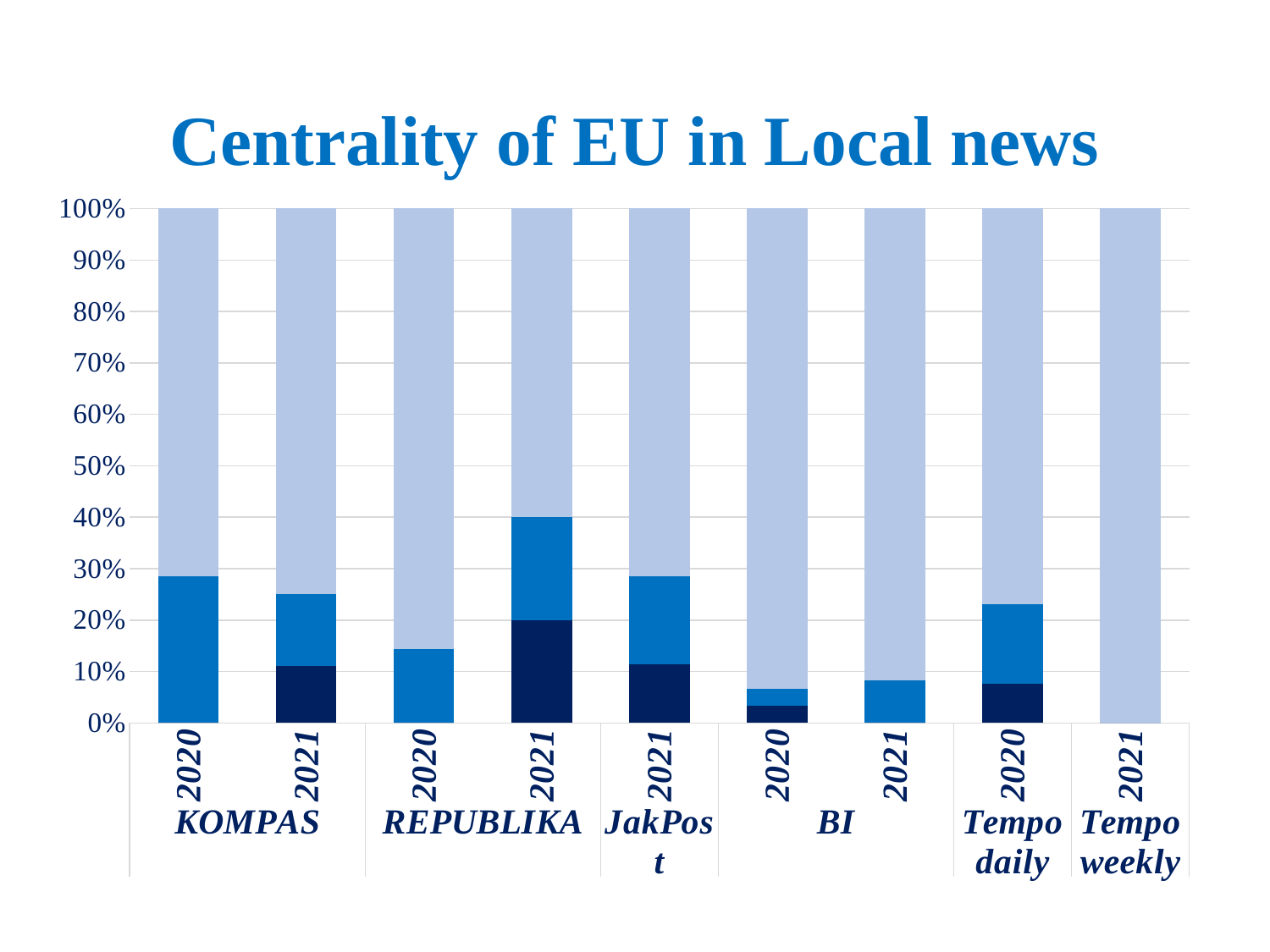
Is the top of the medium-blue segment for Tempo daily 2020 greater or less than 20%? greater Is the top of the medium-blue segment for KOMPAS 2020 greater or less than 20%? greater How many news outlets are labelled along the x axis? 6 What is the title of the chart? Centrality of EU in Local news What kind of chart is shown on the slide? stacked bar chart Is the top of the medium-blue segment for BI 2020 greater or less than 10%? less Which bar has the tallest medium-blue segment (reaching highest up the axis)? REPUBLIKA 2021 Which bar has no dark-blue or medium-blue segment at all, being entirely light blue? Tempo weekly 2021 How many bars are plotted in the chart? 9 Which reaches higher up the axis: the medium-blue segment for REPUBLIKA 2020 or for REPUBLIKA 2021? REPUBLIKA 2021 Which reaches higher up the axis: the dark-blue segment for KOMPAS 2021 or for BI 2020? KOMPAS 2021